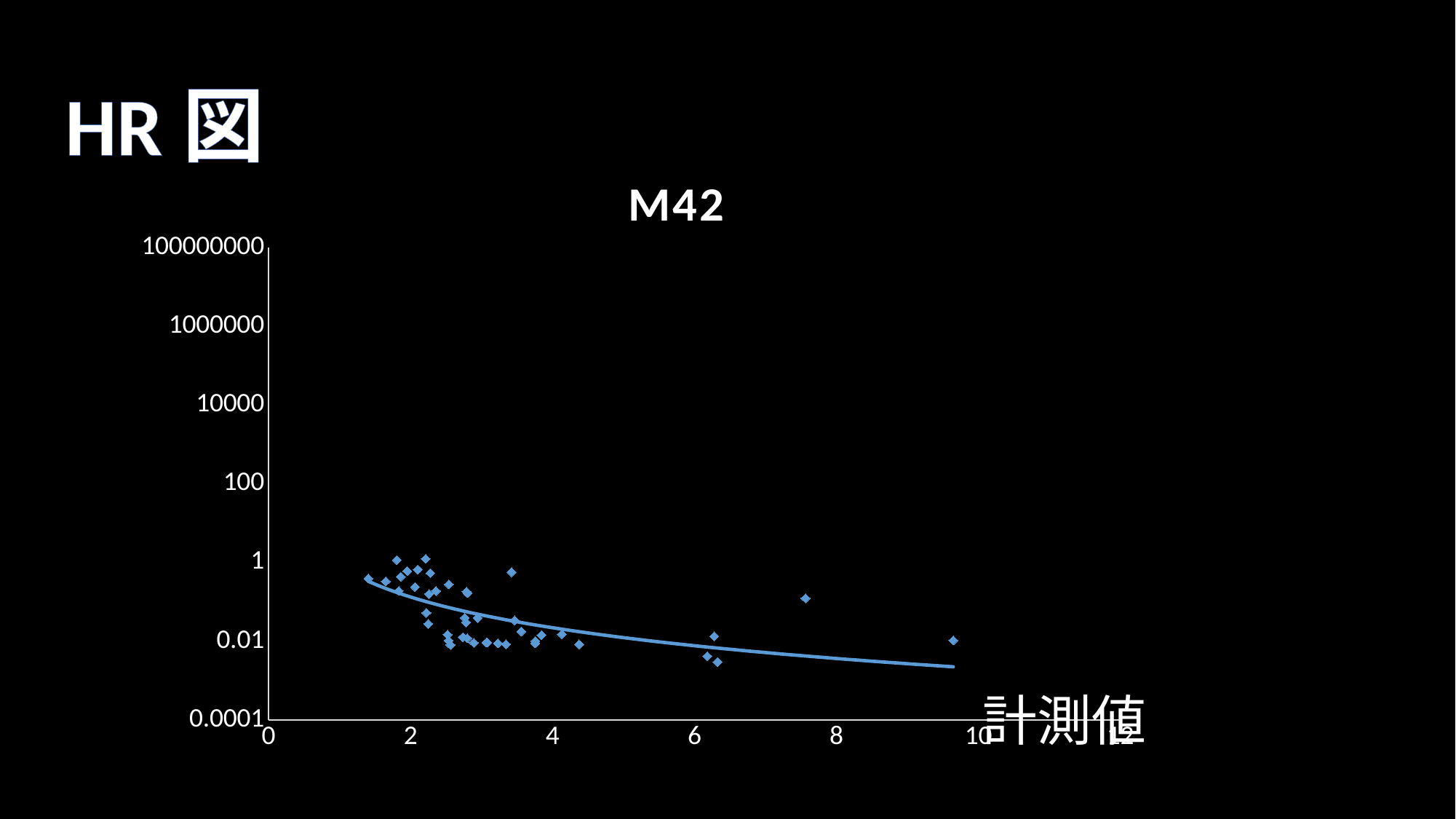
Is the value of the point plotted near x = 7.5 greater or less than 1? less Do the plotted values generally rise or fall as the x value increases? fall What is the highest tick label shown on the y axis? 100000000 Is the value of the point plotted near x = 7.5 greater or less than 0.01? greater What kind of chart is shown on the slide? scatter chart Are the values of the points plotted near x = 6.2 greater or less than 100? less What is the highest tick label shown on the x axis? 10 What is the title of the chart? M42